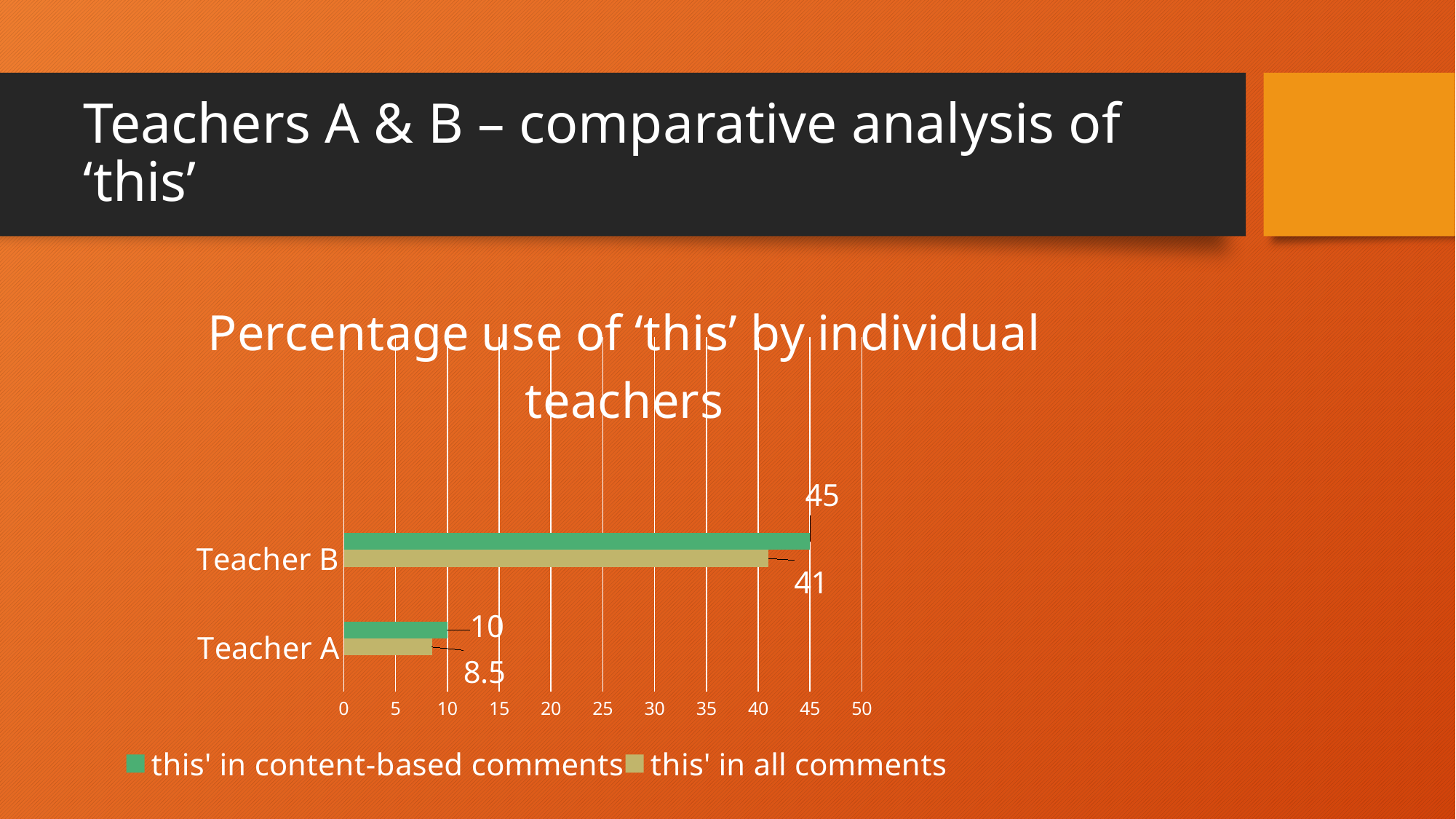
What is the difference between Teacher B's and Teacher A's values for 'this' in content-based comments? 35 How many teachers (categories) are shown in the chart? 2 What kind of chart is shown on the slide? Bar chart What is the value for Teacher A in the 'this' in content-based comments series? 10 Which teacher has the lowest value for 'this' in all comments? Teacher A What is the value for Teacher B in the 'this' in all comments series? 41 Which is larger for Teacher A: 'this' in content-based comments or 'this' in all comments? 'this' in content-based comments What is the value for Teacher A in the 'this' in all comments series? 8.5 What is the value for Teacher B in the 'this' in content-based comments series? 45 Which teacher has the highest value for 'this' in content-based comments? Teacher B How many series does the legend list? 2 What is the difference between Teacher B's values for 'this' in content-based comments and 'this' in all comments? 4